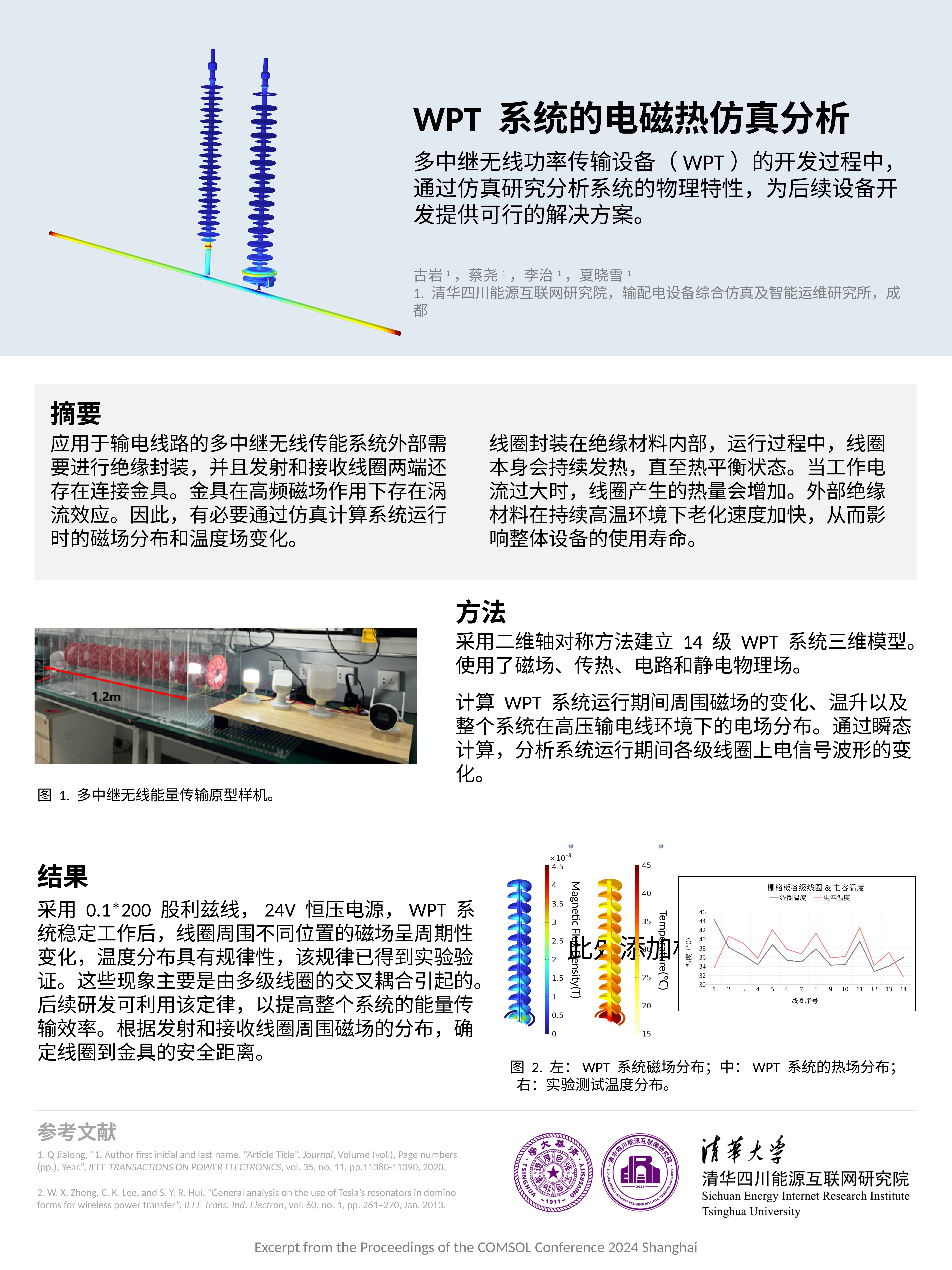
What kind of chart is the chart titled 栅格板各级线圈 & 电容温度? line chart In the 栅格板各级线圈 & 电容温度 chart, which coil number has the highest 线圈温度? 1 What is the x-axis label of the 栅格板各级线圈 & 电容温度 chart? 线圈序号 In the 栅格板各级线圈 & 电容温度 chart, is the 电容温度 for coil 5 greater or less than 40? greater How many series does the legend of the 栅格板各级线圈 & 电容温度 chart list? 2 In the 栅格板各级线圈 & 电容温度 chart, is the 线圈温度 for coil 1 greater or less than 40? greater In the 栅格板各级线圈 & 电容温度 chart, at coil 1, which is higher: 线圈温度 or 电容温度? 线圈温度 In the 栅格板各级线圈 & 电容温度 chart, is the 电容温度 for coil 1 greater or less than 36? less In the 栅格板各级线圈 & 电容温度 chart, what colour is the 电容温度 line? red In the 栅格板各级线圈 & 电容温度 chart, at coil 2, which is higher: 线圈温度 or 电容温度? 电容温度 How many coil numbers (线圈序号) are plotted along the x axis of the 栅格板各级线圈 & 电容温度 chart? 14